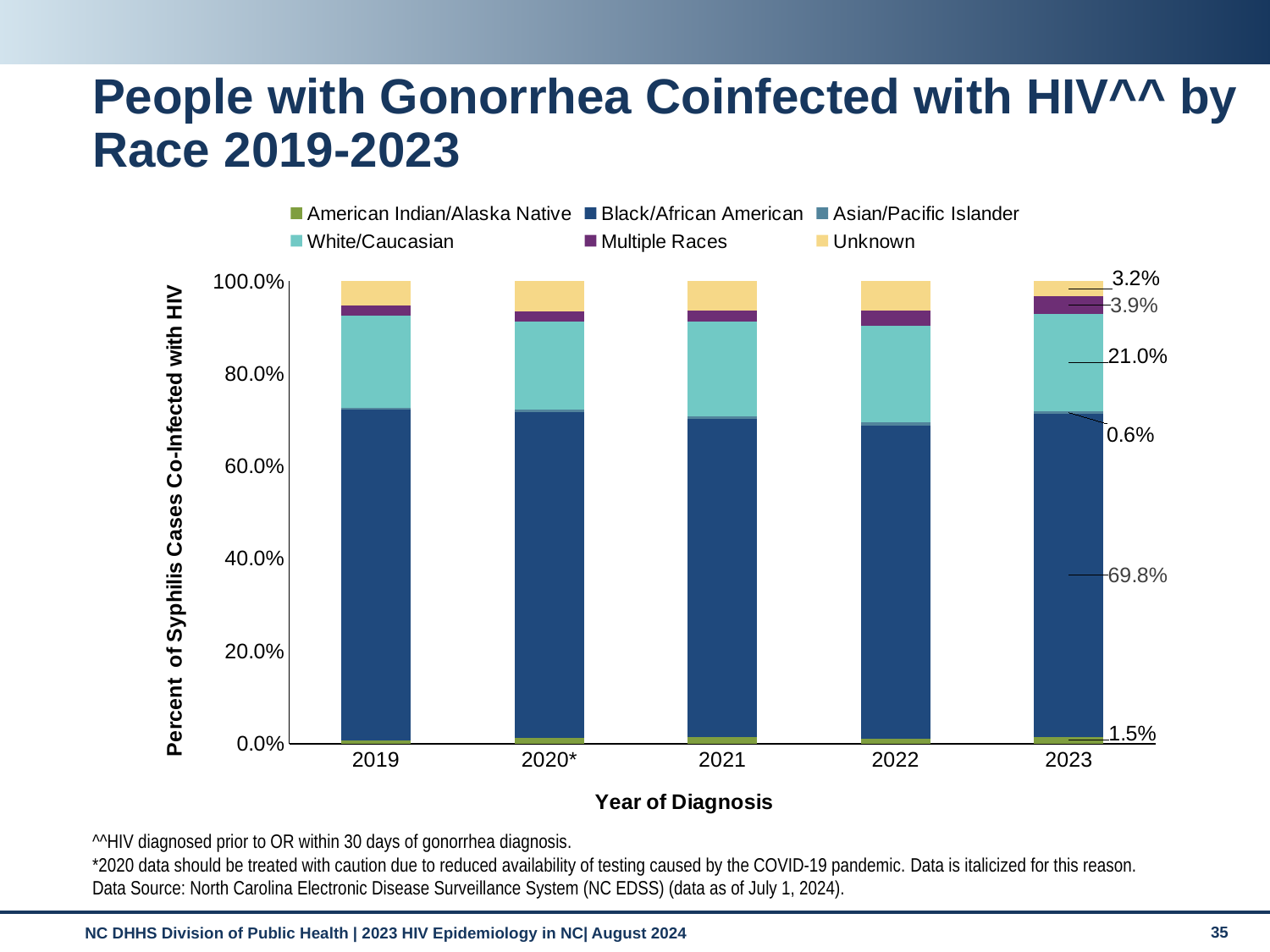
What percentage of the 2023 bar is Black/African American? 69.8% What percentage of the 2023 bar is Multiple Races? 3.9% What percentage of the 2023 bar is American Indian/Alaska Native? 1.5% How many series does the legend list? 6 In 2023, which race group has the largest share? Black/African American What percentage of the 2023 bar is White/Caucasian? 21.0% What type of chart is shown on the slide? Stacked bar chart What percentage of the 2023 bar is Asian/Pacific Islander? 0.6% What is the label of the x axis? Year of Diagnosis What percentage of the 2023 bar is Unknown? 3.2% In 2023, what is the difference between the White/Caucasian share and the Multiple Races share? 17.1% How many years are shown on the x axis? 5